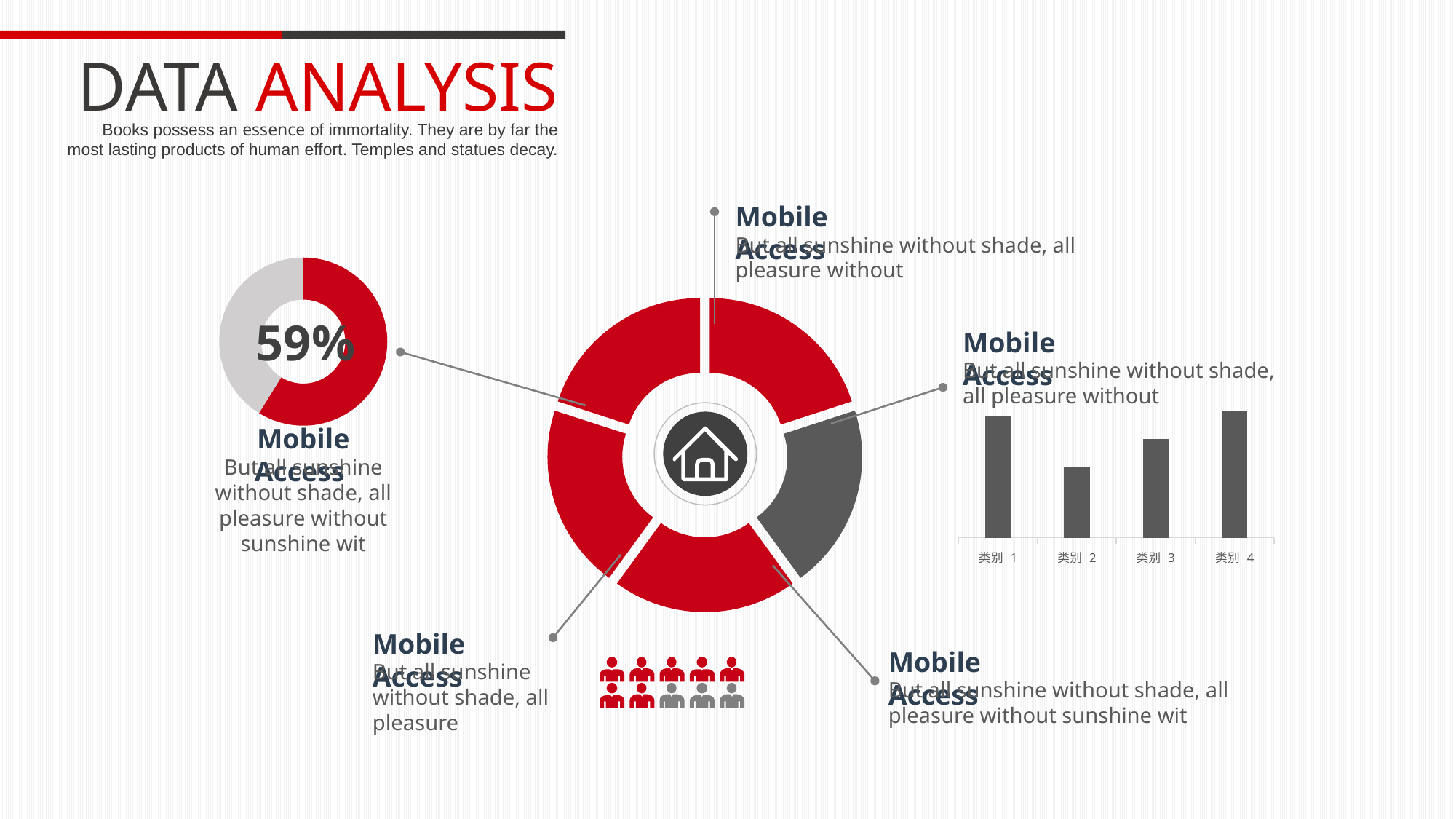
On the bar chart at the right of the slide, what colour are the bars? Dark grey What kind of chart is the small chart at the left of the slide showing 59%? Donut (pie) chart On the bar chart at the right of the slide, which category has the highest bar? 类别 4 On the bar chart at the right of the slide, which bar is taller, 类别 1 or 类别 3? 类别 1 On the bar chart at the right of the slide, which bar is taller, 类别 2 or 类别 4? 类别 4 What kind of chart is the chart at the right of the slide with categories 类别 1 to 类别 4? Bar chart How many segments does the large donut chart in the centre of the slide have? 5 How many segments does the small donut chart at the left of the slide have? 2 On the large donut chart in the centre of the slide, how many segments are red? 4 On the bar chart at the right of the slide, how many categories are shown? 4 On the small donut chart at the left of the slide, what percentage is printed in the centre? 59% On the bar chart at the right of the slide, which category has the lowest bar? 类别 2